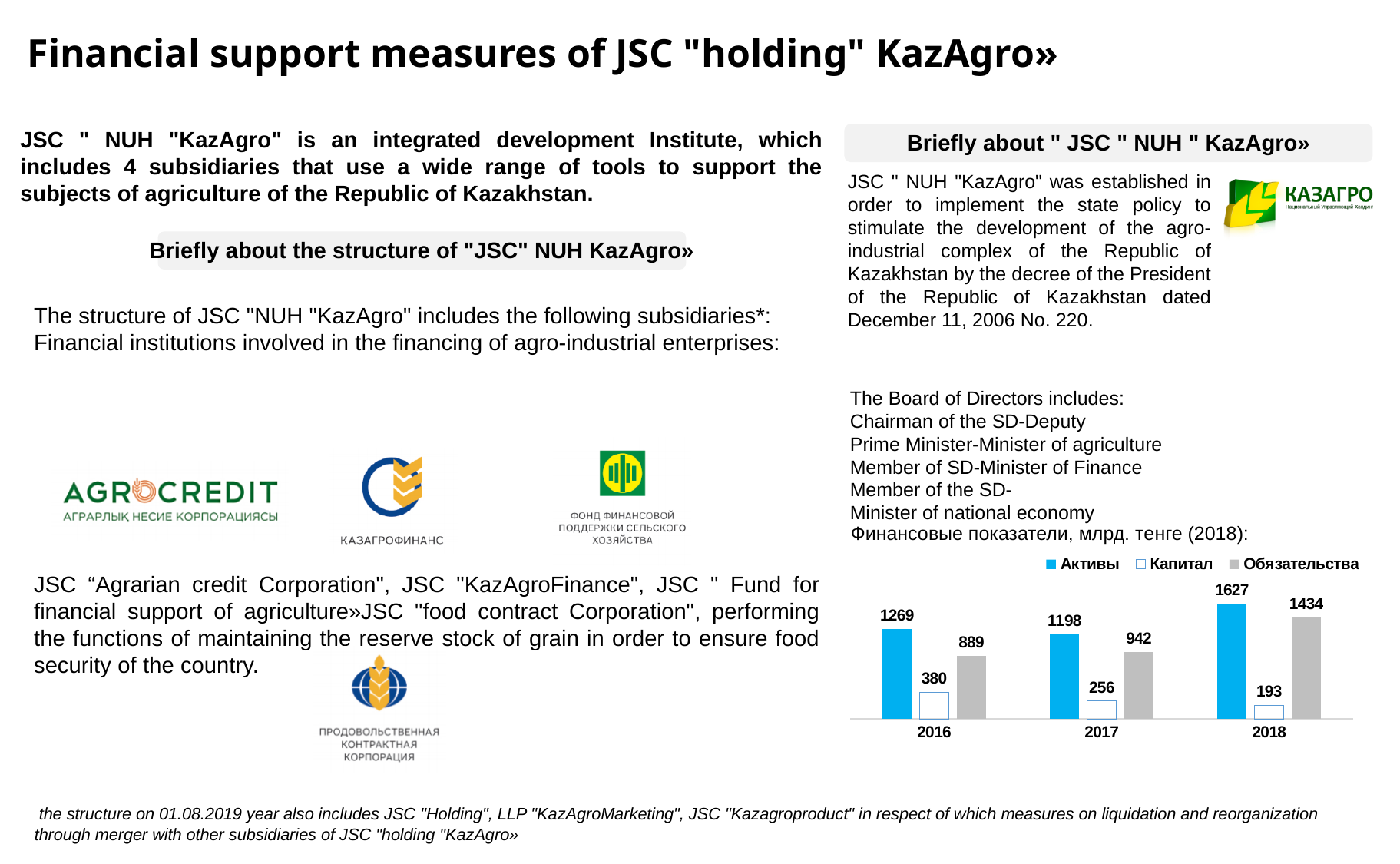
How many years are shown on the x axis of the chart? 3 How many series does the chart legend list? 3 Which colour represents Активы in the chart? Blue Does Капитал rise or fall from 2016 to 2018? Fall In which year is Активы highest? 2018 What is the value of Активы for 2018? 1627 What is the difference between Активы and Обязательства in 2018? 193 What is the value of Капитал for 2016? 380 Which is larger in 2016: Активы or Обязательства? Активы What is the value of Обязательства for 2017? 942 What kind of chart is shown on the slide? Bar chart In which year is Капитал lowest? 2018